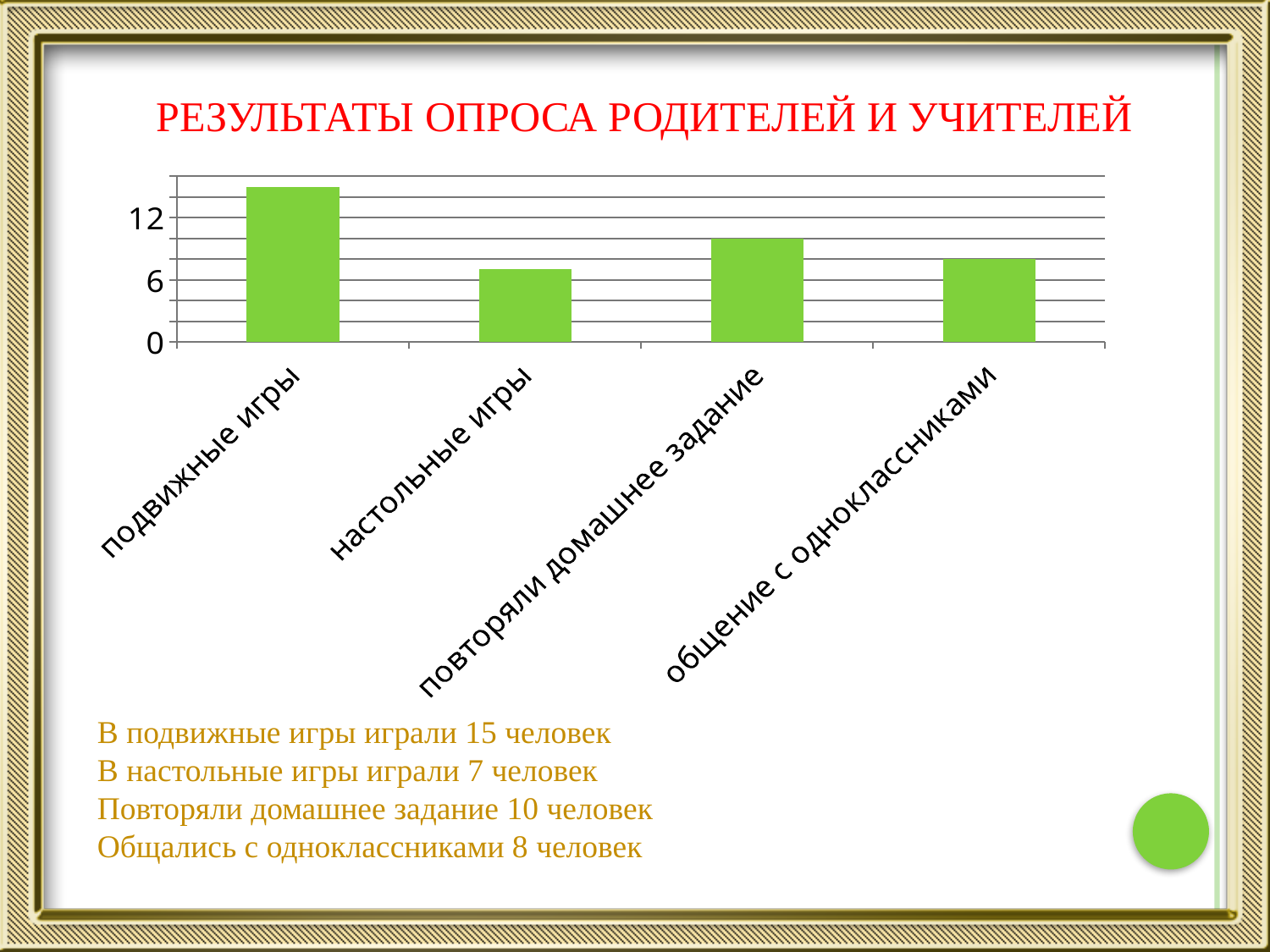
Is the value for повторяли домашнее задание greater or less than 12? less What colour are the bars in the chart? green Is the value for общение с одноклассниками greater or less than 6? greater Is the value for настольные игры greater or less than 12? less Which is larger, the value for подвижные игры or the value for повторяли домашнее задание? подвижные игры Which category has the highest bar in the chart? подвижные игры Which is larger, the value for повторяли домашнее задание or the value for настольные игры? повторяли домашнее задание What kind of chart is shown on the slide? bar chart How many categories are shown on the x axis of the chart? 4 What is the title of the slide containing the chart? РЕЗУЛЬТАТЫ ОПРОСА РОДИТЕЛЕЙ И УЧИТЕЛЕЙ